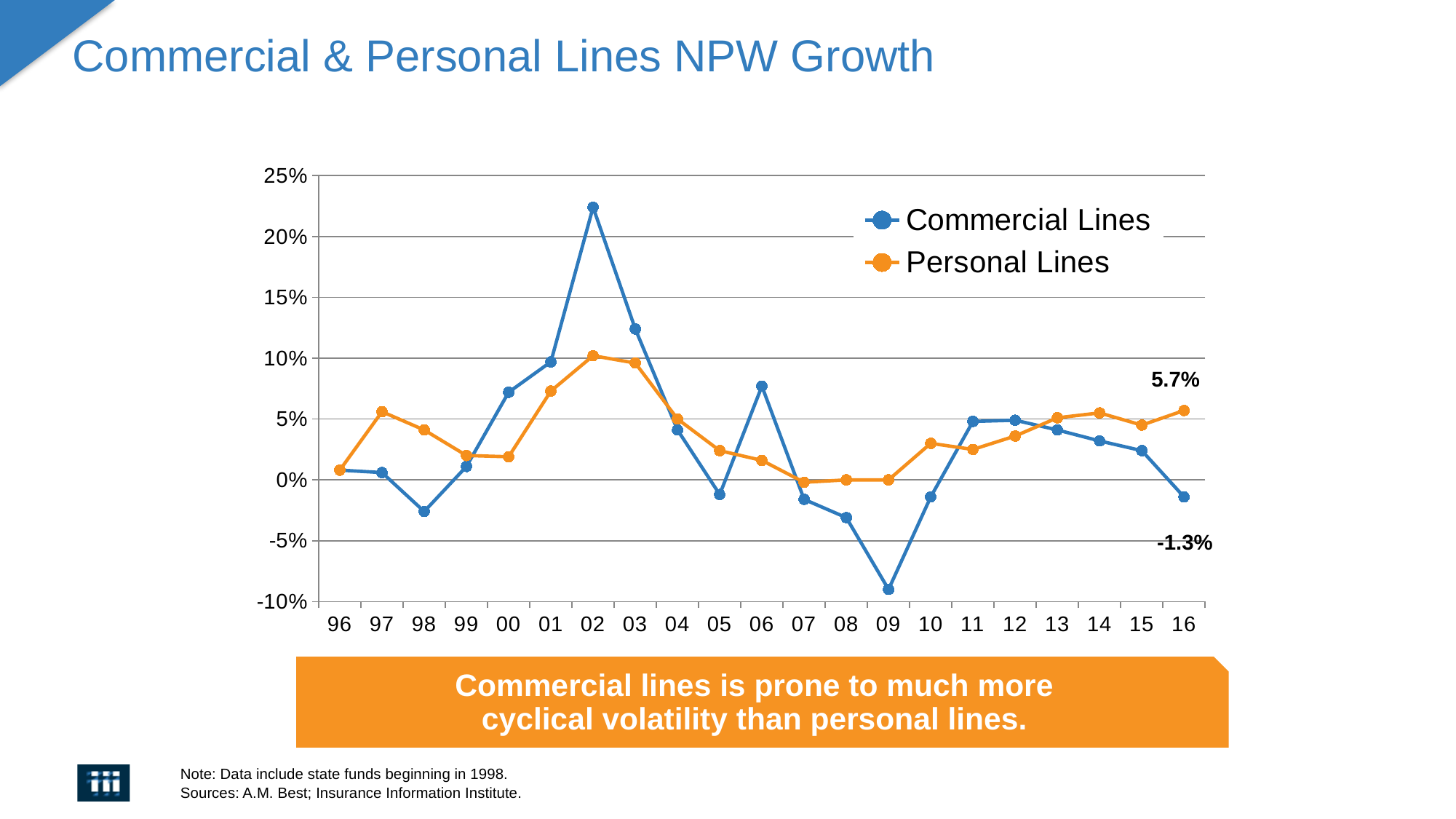
How many years are shown along the x axis? 21 In 97, which series has the higher value, Commercial Lines or Personal Lines? Personal Lines What is the title of the chart on the slide? Commercial & Personal Lines NPW Growth In which year does Commercial Lines reach its lowest value? 09 By how many percentage points does Personal Lines exceed Commercial Lines in 16? 7.0 percentage points What is the Commercial Lines NPW growth value for 16? -1.3% What is the Personal Lines NPW growth value for 16? 5.7% How many series does the legend list? 2 Is the Commercial Lines value for 02 greater or less than 20%? greater In which year does Commercial Lines reach its highest value? 02 Is the Commercial Lines value for 09 greater or less than -5%? less What kind of chart is shown on the slide? line chart